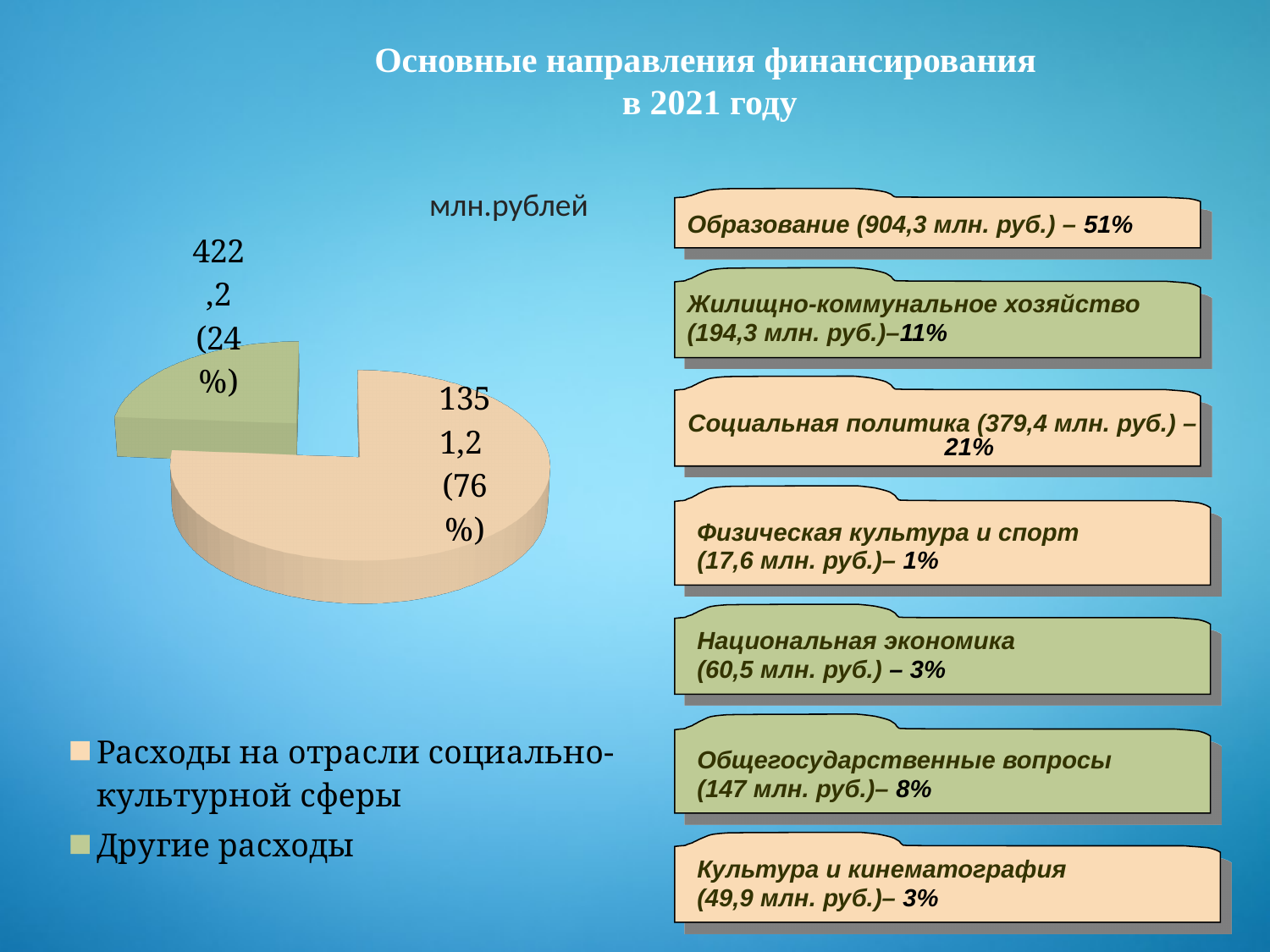
What unit is given in the title of the pie chart? млн.рублей Which is larger in the pie chart: "Расходы на отрасли социально-культурной сферы" or "Другие расходы"? Расходы на отрасли социально-культурной сферы What value is shown for "Другие расходы" in the pie chart? 422,2 What colour is the "Другие расходы" slice in the pie chart? green What kind of chart is shown on the slide? pie chart How many entries does the legend of the pie chart list? 2 What share of the pie does "Другие расходы" represent? 24% Which slice of the pie chart is the smallest? Другие расходы What value is shown for "Расходы на отрасли социально-культурной сферы" in the pie chart? 1351,2 Which slice of the pie chart is the largest? Расходы на отрасли социально-культурной сферы What share of the pie does "Расходы на отрасли социально-культурной сферы" represent? 76% How many slices does the pie chart have? 2